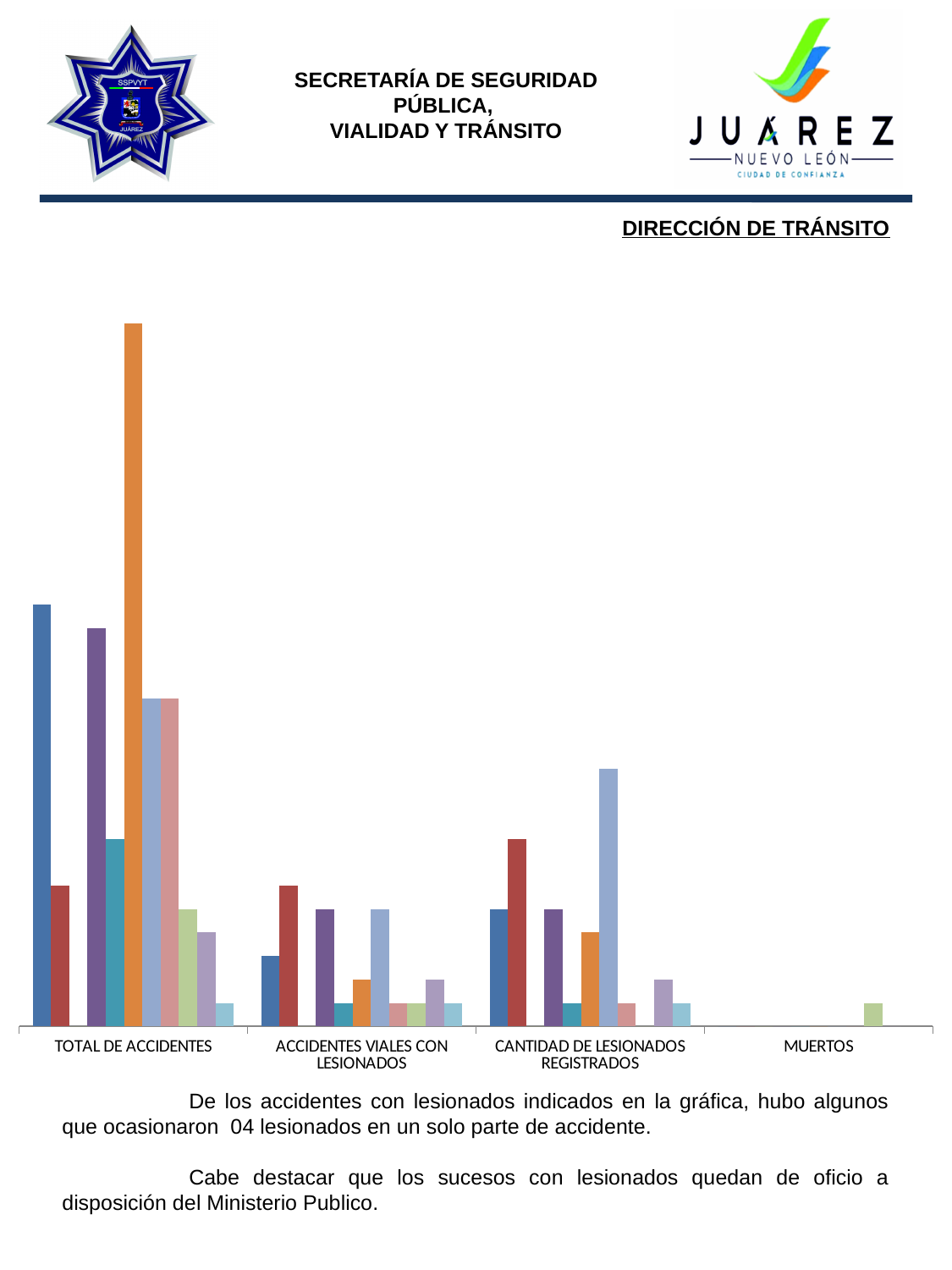
Which category contains the tallest bar on the chart? TOTAL DE ACCIDENTES What colour is the tallest bar on the chart? Orange How many visible bars are there in the MUERTOS category? 1 Which category has the lowest bars on the chart? MUERTOS How many categories are shown along the x axis of the chart? 4 Which category has the taller highest bar, ACCIDENTES VIALES CON LESIONADOS or CANTIDAD DE LESIONADOS REGISTRADOS? CANTIDAD DE LESIONADOS REGISTRADOS Which category has taller bars overall, TOTAL DE ACCIDENTES or MUERTOS? TOTAL DE ACCIDENTES Does the chart display a legend? No Are the bars in the chart vertical or horizontal? Vertical What kind of chart is shown on the slide? Bar chart